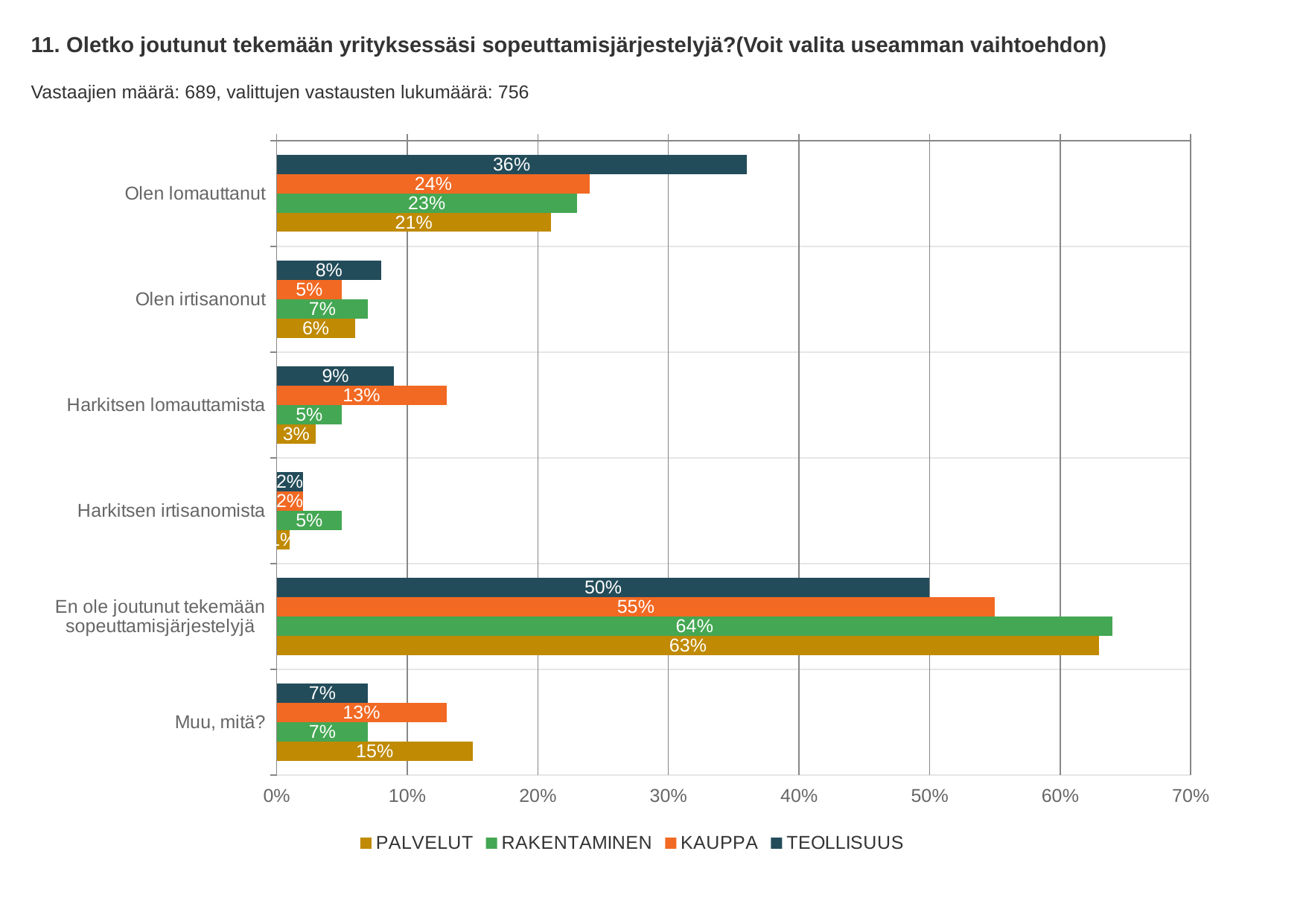
What is the PALVELUT value for "Muu, mitä?"? 15% Which series has the highest value for "Olen lomauttanut"? TEOLLISUUS What is the RAKENTAMINEN value for "En ole joutunut tekemään sopeuttamisjärjestelyjä"? 64% What is the difference between the PALVELUT and TEOLLISUUS values for "En ole joutunut tekemään sopeuttamisjärjestelyjä"? 13% How many categories are shown on the vertical axis? 6 Which is larger for "Olen irtisanonut": the TEOLLISUUS value or the KAUPPA value? TEOLLISUUS Is the KAUPPA value for "En ole joutunut tekemään sopeuttamisjärjestelyjä" greater or less than 50%? greater How many series does the legend list? 4 What is the TEOLLISUUS value for "Olen lomauttanut"? 36% What is the KAUPPA value for "Harkitsen lomauttamista"? 13% Which series has the lowest value for "En ole joutunut tekemään sopeuttamisjärjestelyjä"? TEOLLISUUS What kind of chart is shown on the slide? bar chart